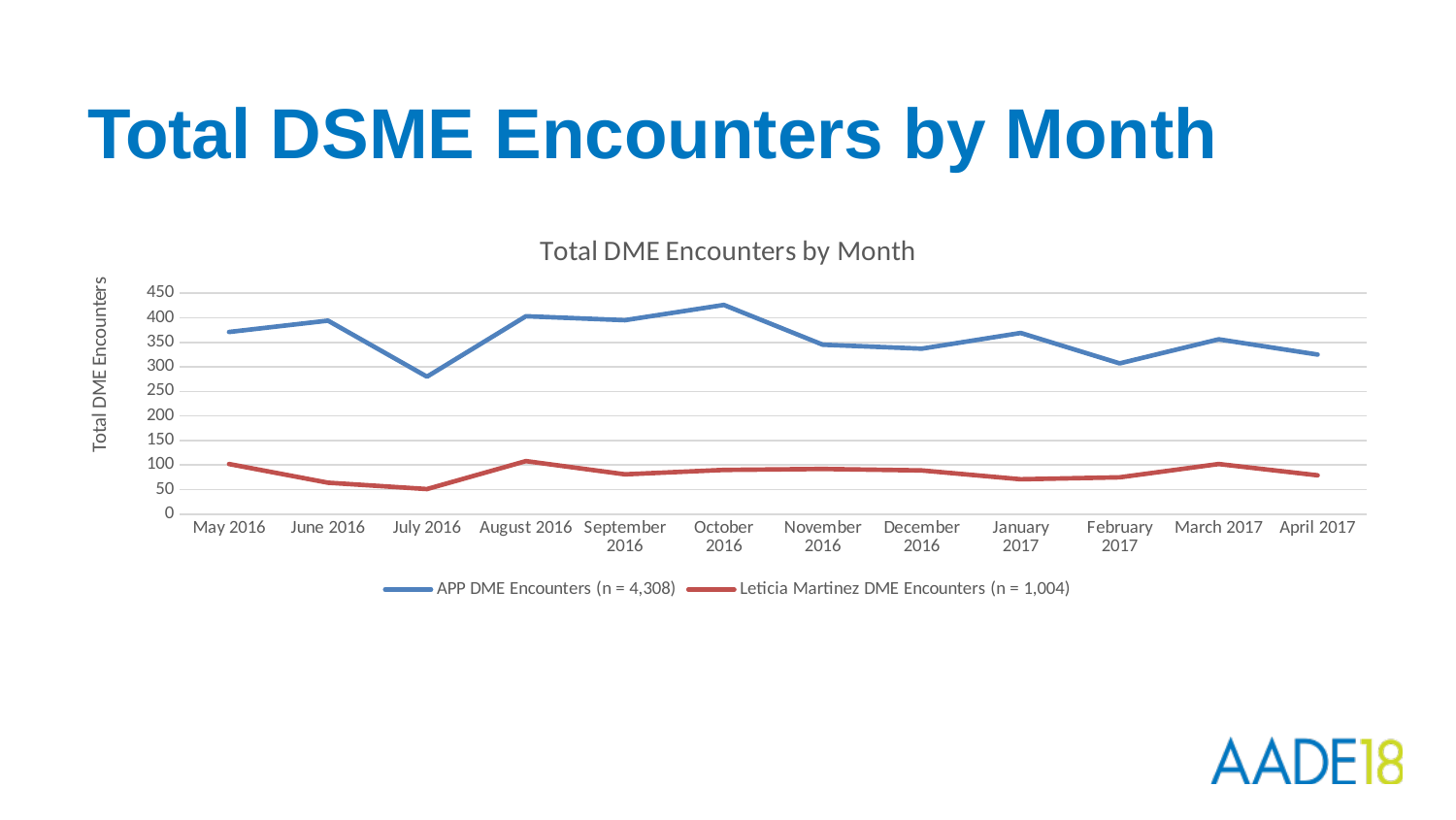
Is the value for APP DME Encounters in October 2016 greater or less than 400? greater What kind of chart is shown on the slide? Line chart Which month has the larger value for APP DME Encounters, June 2016 or July 2016? June 2016 Which series has the larger value in December 2016, APP DME Encounters or Leticia Martinez DME Encounters? APP DME Encounters How many series does the legend list? 2 Do APP DME Encounters rise or fall from October 2016 to November 2016? fall How many months are plotted along the x axis? 12 What is the label on the vertical axis of the chart? Total DME Encounters Is the value for APP DME Encounters in July 2016 greater or less than 300? less Is the value for Leticia Martinez DME Encounters in July 2016 greater or less than 100? less In which month do APP DME Encounters reach their lowest value? July 2016 In which month do APP DME Encounters reach their highest value? October 2016